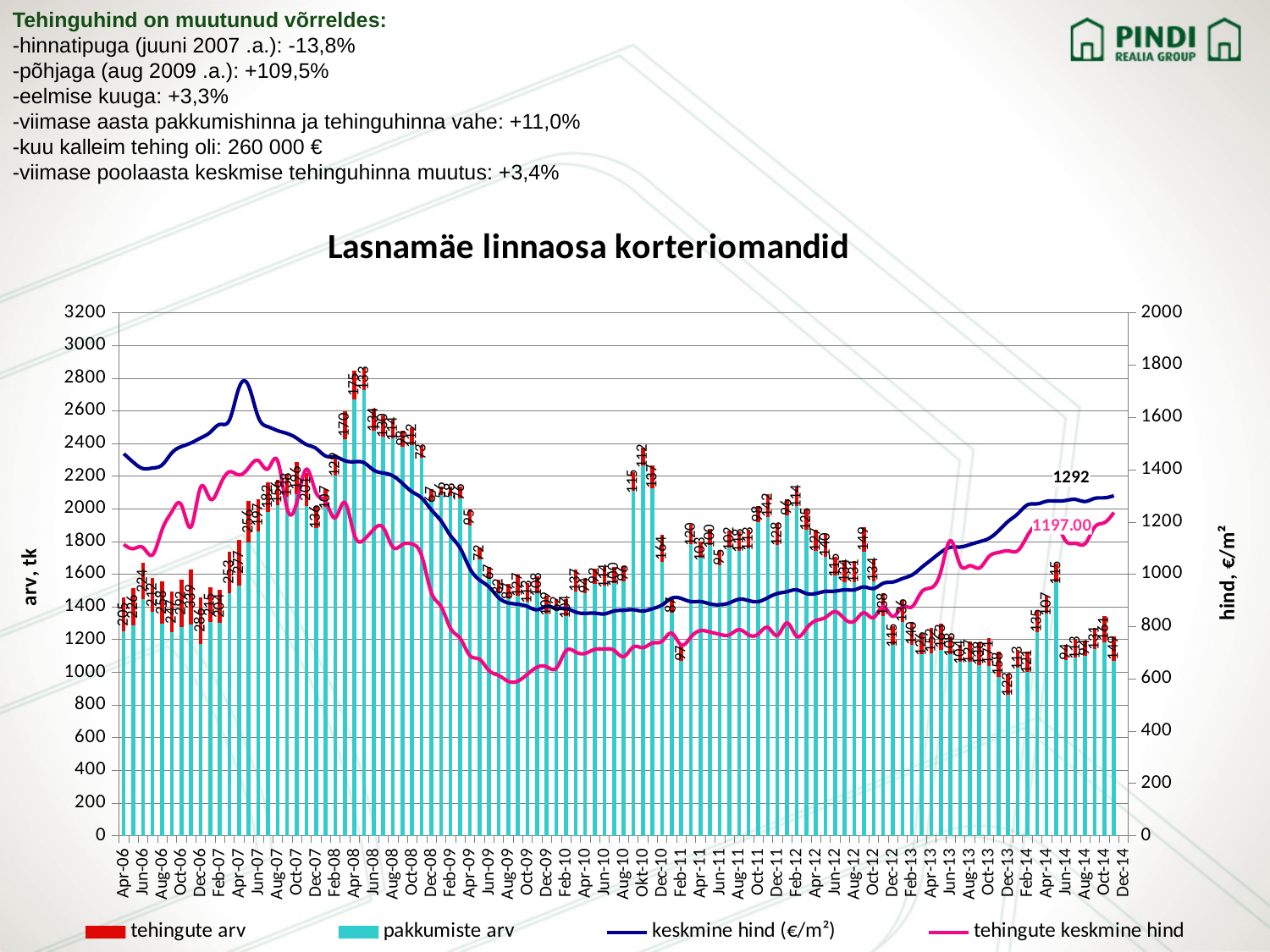
What kind of chart is this? Combined bar and line chart What is the last labelled value of the tehingute keskmine hind line at the right end of the chart? 1197.00 At the right end of the chart, which line is higher: keskmine hind (€/m²) or tehingute keskmine hind? keskmine hind (€/m²) What is the title of the chart? Lasnamäe linnaosa korteriomandid Does the tehingute keskmine hind line rise or fall between Feb-13 and Dec-14? rise What is the difference between the final labelled keskmine hind value (1292) and the final labelled tehingute keskmine hind value (1197.00)? 95 Does the keskmine hind (€/m²) line rise or fall between Apr-07 and Aug-09? fall What is the last labelled value of the keskmine hind (€/m²) line at the right end of the chart? 1292 Is the tallest pakkumiste arv bar (around Apr-08 to Jun-08) greater or less than 2600 on the left axis? greater How many series does the chart legend list? 4 Is the peak of the keskmine hind (€/m²) line around Apr-07 greater or less than 1600 on the right axis? greater Is the tehingute keskmine hind line around Aug-09 greater or less than 800 on the right axis? less